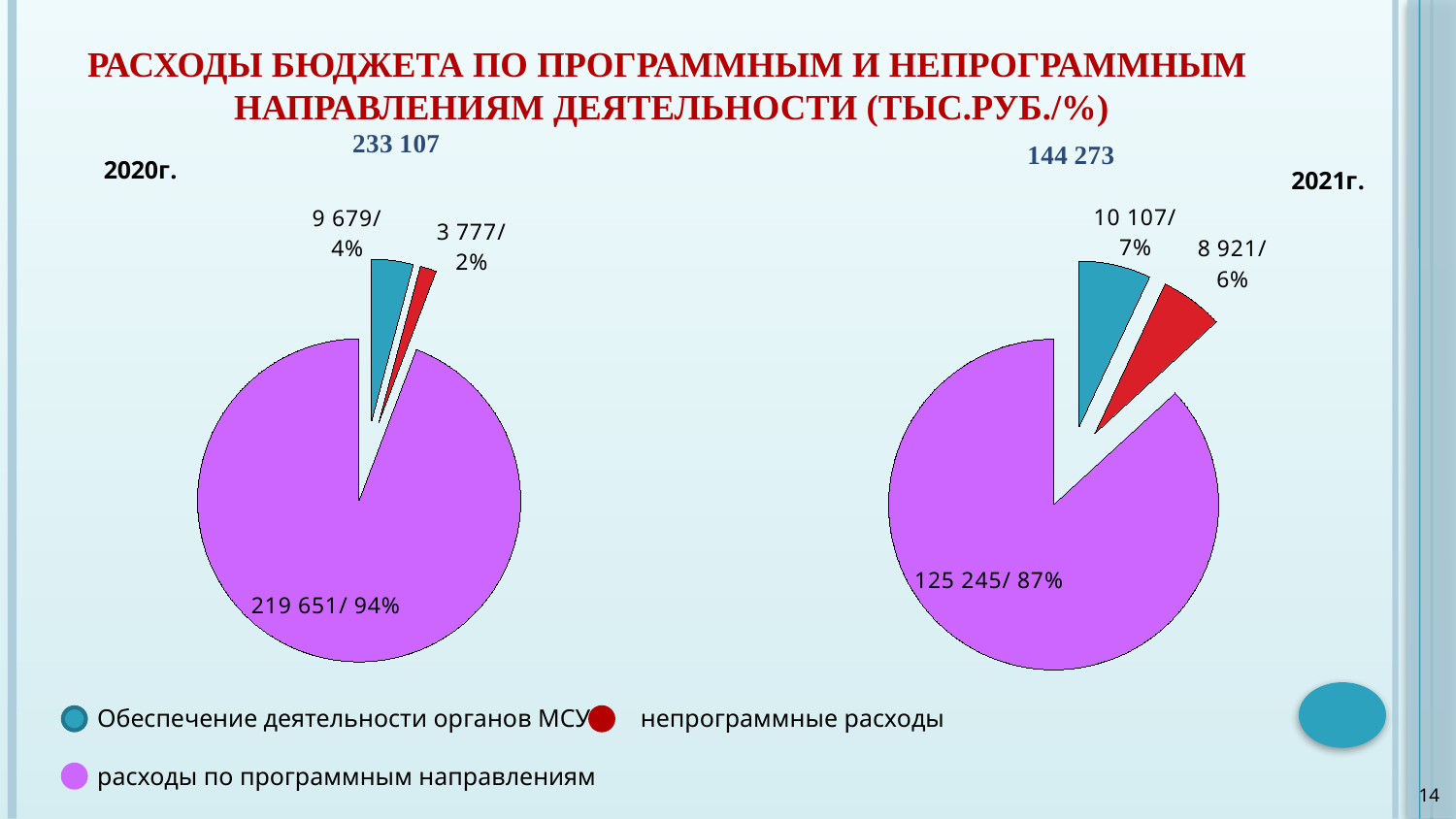
What total is printed above the 2021г. pie chart? 144 273 In the 2020г. pie chart, what share of the pie does непрограммные расходы take? 2% Which is larger: the value for Обеспечение деятельности органов МСУ in 2020г. or in 2021г.? 2021г. In the 2021г. pie chart, what share of the pie does расходы по программным направлениям take? 87% In the 2021г. pie chart, what value is shown for непрограммные расходы? 8 921/ 6% In the 2021г. pie chart, what value is shown for Обеспечение деятельности органов МСУ? 10 107/ 7% What type of chart is used for the 2020г. data on the slide? pie chart In the 2020г. pie chart, what is the difference between the values for Обеспечение деятельности органов МСУ and непрограммные расходы? 5 902 How many slices does each pie chart on the slide have? 3 In the 2020г. pie chart, what value is shown for расходы по программным направлениям? 219 651/ 94% In the 2020г. pie chart, which category has the smallest slice? непрограммные расходы In the 2021г. pie chart, which category has the largest slice? расходы по программным направлениям